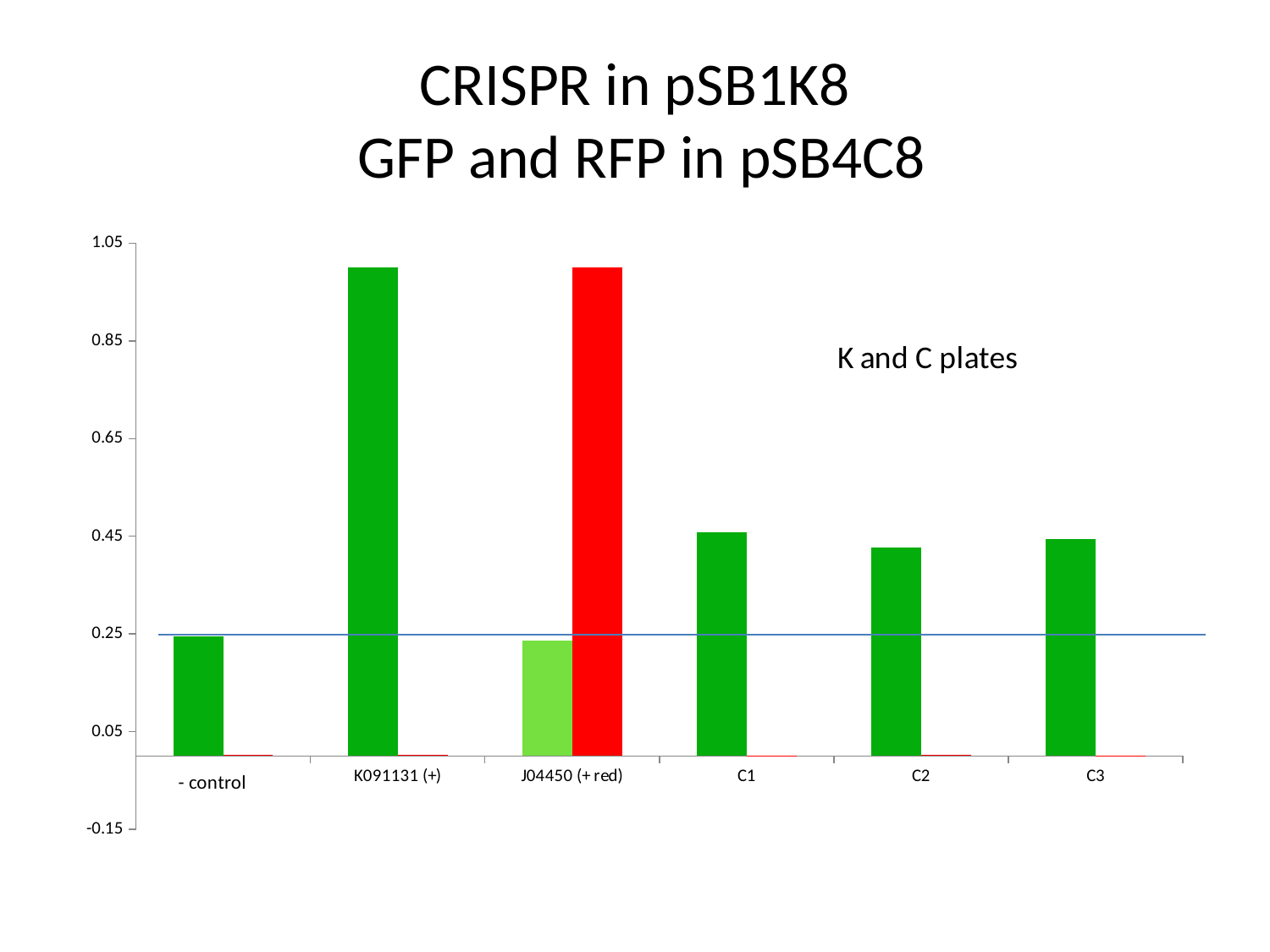
Is the red bar for J04450 (+ red) greater or less than 0.85? greater How many categories are shown on the x axis of the chart? 6 Is the green bar for C1 greater or less than 0.25? greater What kind of chart is shown on the slide? bar chart What is the title of the slide? CRISPR in pSB1K8 GFP and RFP in pSB4C8 Which category has the tallest green bar? K091131 (+) Is the green bar for K091131 (+) greater or less than 0.85? greater What colour is the tallest bar for J04450 (+ red)? red Which has the taller green bar, C1 or - control? C1 Which has the taller green bar, K091131 (+) or C1? K091131 (+)